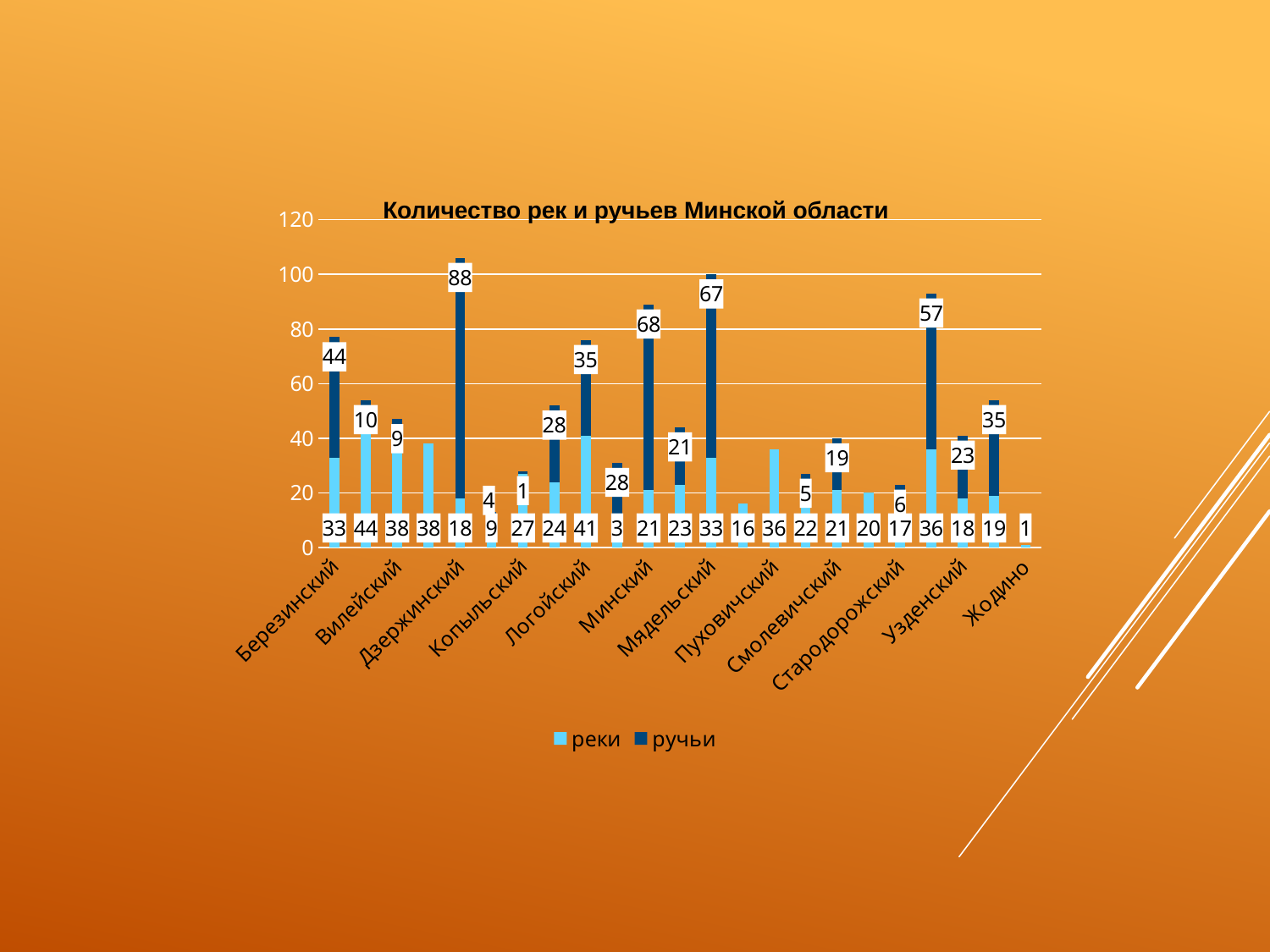
Is the total stacked bar for Дзержинский greater or less than 100? greater What kind of chart is shown on the slide? stacked bar chart What is the difference between ручьи and реки for Минский? 47 What is the title of the chart? Количество рек и ручьев Минской области How many series does the legend list? 2 What are the two series named in the legend? реки and ручьи What is the value of реки for Жодино? 1 Which is larger for Березинский, реки or ручьи? ручьи What is the value of реки for Логойский? 41 Which labelled district has the highest value of ручьи? Дзержинский What is the total of the stacked bar for Мядельский (реки plus ручьи)? 100 What is the value of ручьи for Дзержинский? 88